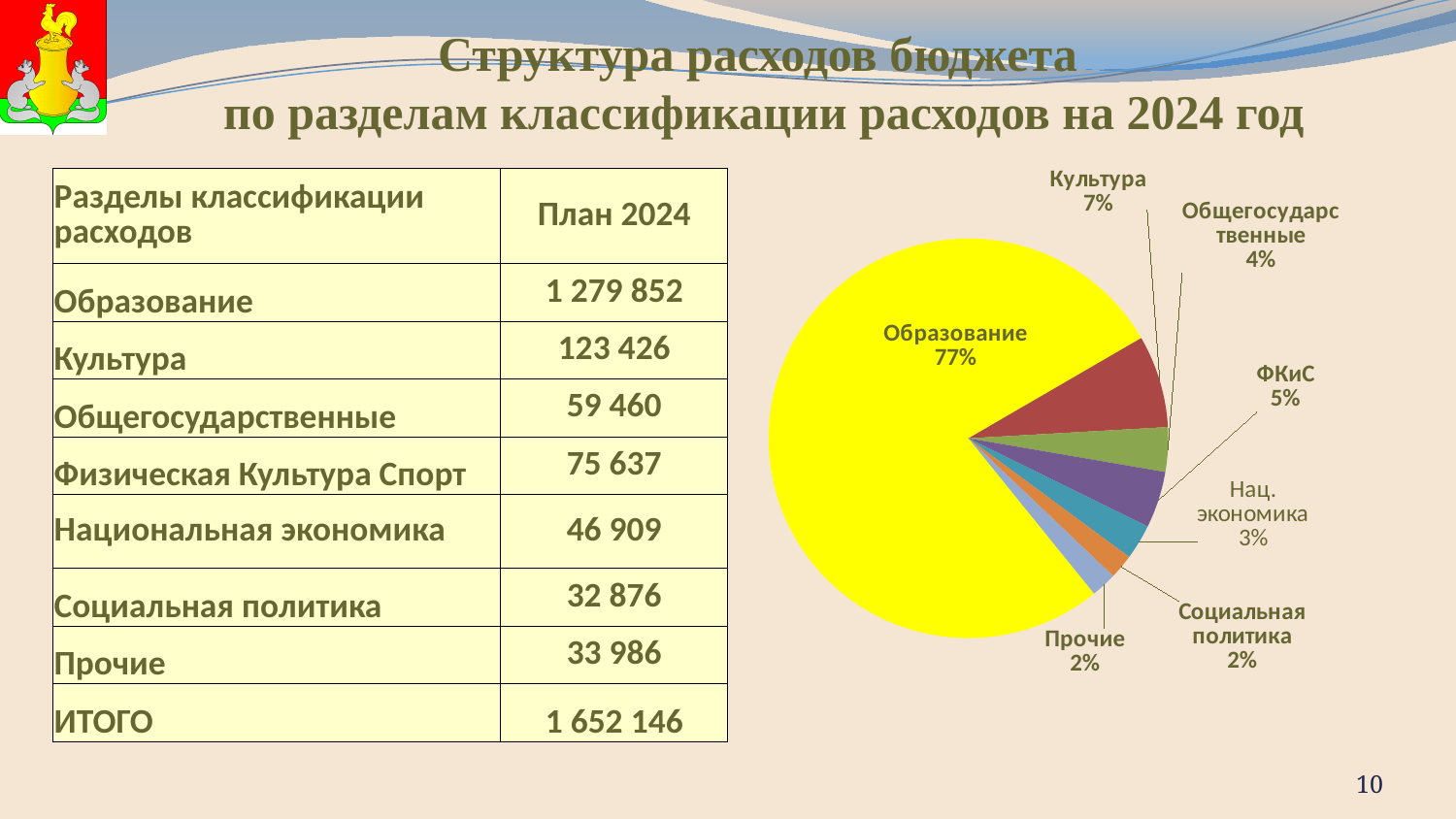
Which category has the largest slice of the pie chart? Образование What share of the pie does Образование take? 77% What percentage is shown for Социальная политика in the pie chart? 2% What percentage is shown for Культура in the pie chart? 7% What percentage is shown for Общегосударственные in the pie chart? 4% How many slices does the pie chart have? 7 What is the difference in percentage points between Образование and Культура in the pie chart? 70 Which slice is larger, Культура or ФКиС? Культура What kind of chart is shown on the slide? pie chart What percentage is shown for ФКиС in the pie chart? 5% What colour is the Образование slice in the pie chart? yellow What percentage is shown for Нац. экономика in the pie chart? 3%